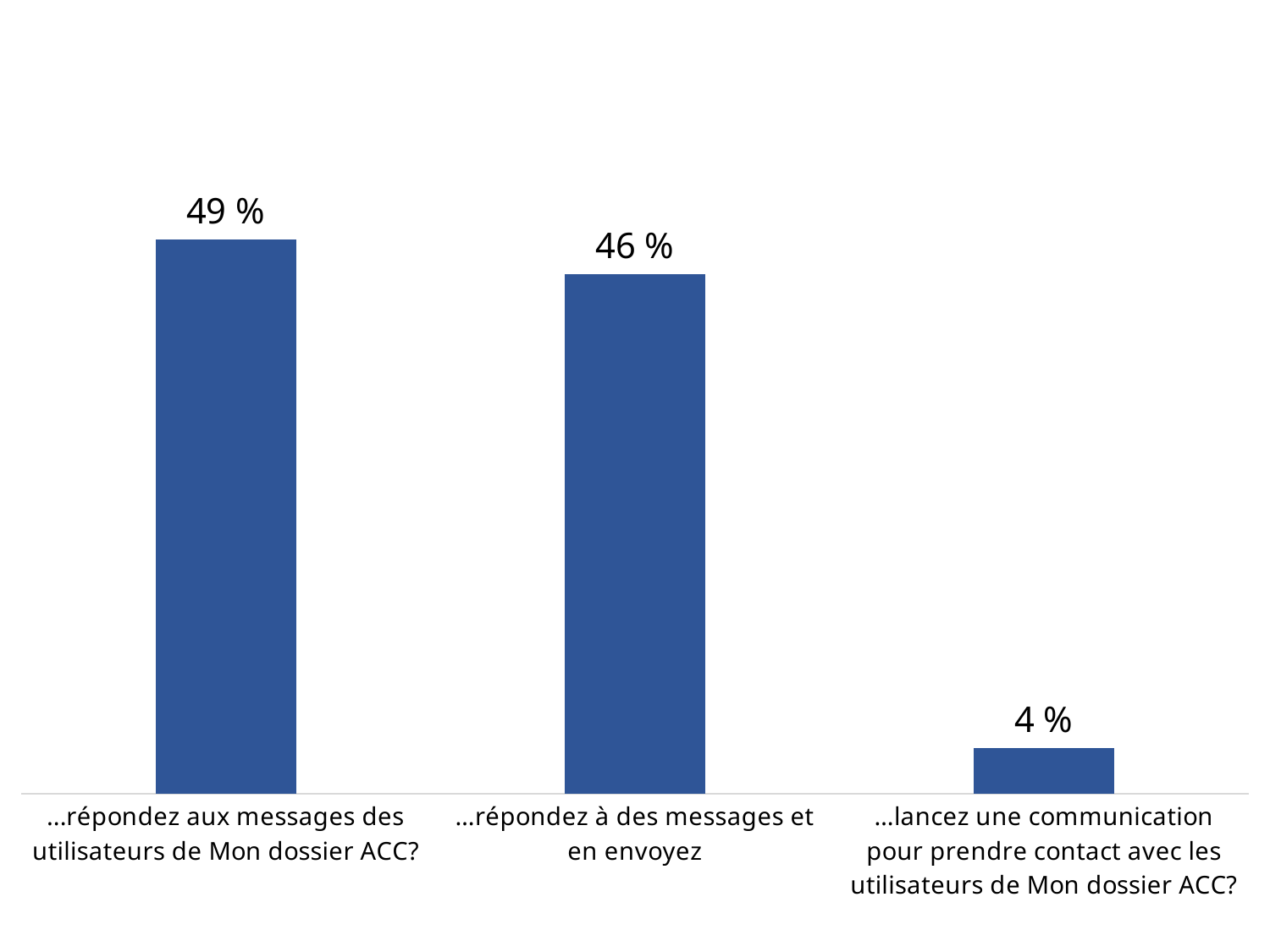
What colour are the bars in the chart? Blue Which category has the highest value? …répondez aux messages des utilisateurs de Mon dossier ACC? What is the difference between the values for "…répondez à des messages et en envoyez" and "…lancez une communication pour prendre contact avec les utilisateurs de Mon dossier ACC?"? 42 % What kind of chart is shown on the slide? Bar chart Which is larger: the value for "…répondez à des messages et en envoyez" or the value for "…lancez une communication pour prendre contact avec les utilisateurs de Mon dossier ACC?"? …répondez à des messages et en envoyez Do the values rise or fall from left to right across the categories? Fall What is the difference between the values for "…répondez aux messages des utilisateurs de Mon dossier ACC?" and "…répondez à des messages et en envoyez"? 3 % What is the value for "…répondez aux messages des utilisateurs de Mon dossier ACC?"? 49 % What is the value for "…répondez à des messages et en envoyez"? 46 % Which category has the lowest value? …lancez une communication pour prendre contact avec les utilisateurs de Mon dossier ACC? What is the value for "…lancez une communication pour prendre contact avec les utilisateurs de Mon dossier ACC?"? 4 % How many categories are shown in the chart? 3